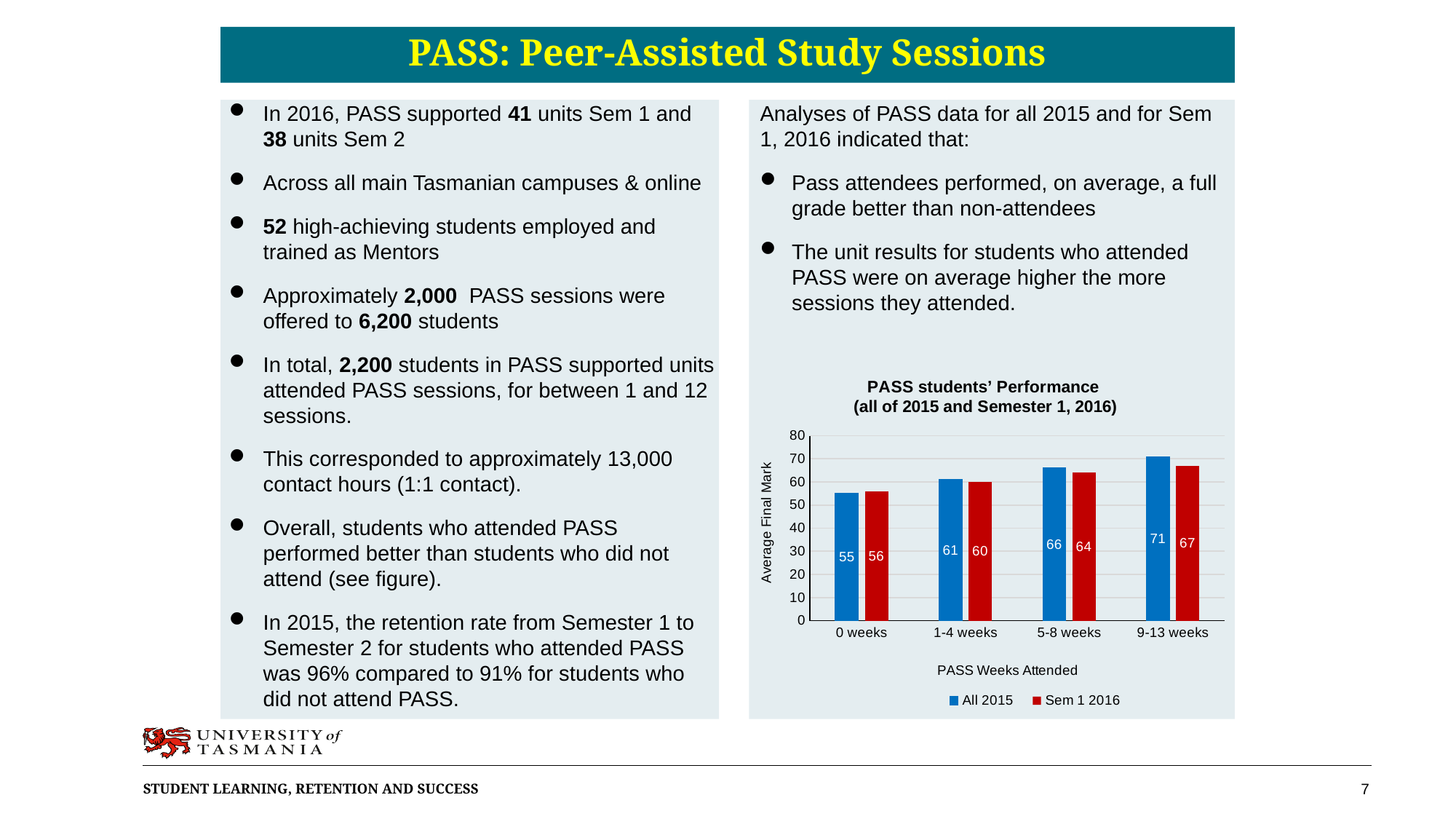
What is the average final mark for All 2015 students who attended 5-8 weeks of PASS? 66 Do the All 2015 average final marks rise or fall as the number of PASS weeks attended increases? Rise For 1-4 weeks, which series has the higher average final mark, All 2015 or Sem 1 2016? All 2015 What kind of chart is shown on the slide? Bar chart Which PASS weeks attended category has the highest average final mark for All 2015? 9-13 weeks How many series does the legend list? 2 What is the average final mark for All 2015 students who attended 0 weeks of PASS? 55 What is the average final mark for Sem 1 2016 students who attended 9-13 weeks of PASS? 67 What is the difference between the All 2015 and Sem 1 2016 average final marks for 9-13 weeks? 4 How many PASS weeks attended categories are shown on the x axis? 4 What is the difference in the All 2015 average final mark between 9-13 weeks and 0 weeks? 16 Which PASS weeks attended category has the lowest average final mark for Sem 1 2016? 0 weeks